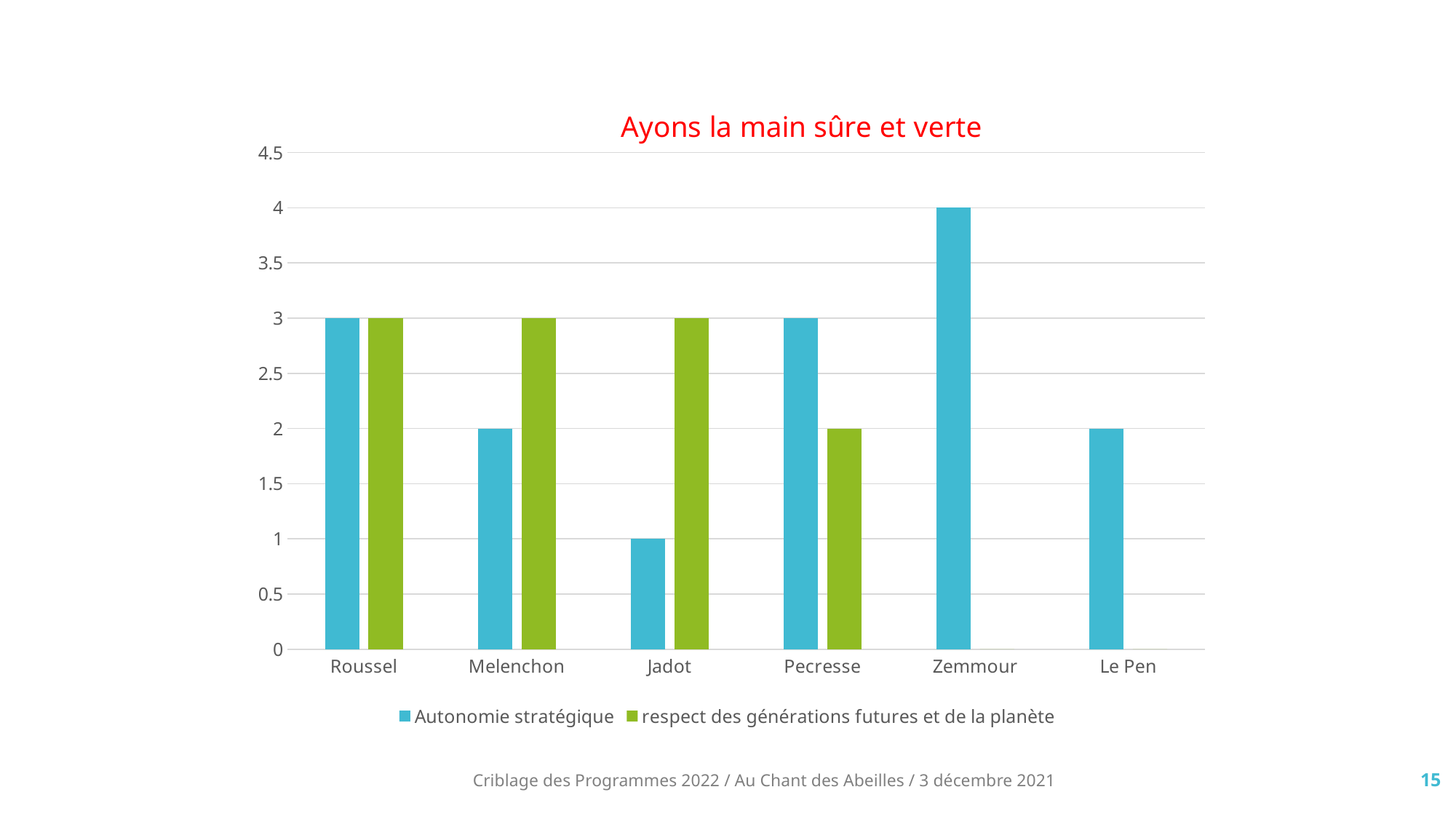
Is the value for Zemmour in the Autonomie stratégique series greater or less than 3.5? greater What kind of chart is shown on the slide? bar chart How many series does the legend list? 2 What is the difference between Zemmour's and Jadot's values for Autonomie stratégique? 3 What is the value for Pecresse in the respect des générations futures et de la planète series? 2 What is the value for Zemmour in the Autonomie stratégique series? 4 Which candidate has the highest value for Autonomie stratégique? Zemmour What is the value for Jadot in the Autonomie stratégique series? 1 Which candidate has the lowest value for Autonomie stratégique? Jadot What is the title of the chart? Ayons la main sûre et verte For Melenchon, which series has the larger value: Autonomie stratégique or respect des générations futures et de la planète? respect des générations futures et de la planète How many candidates are shown on the x axis? 6